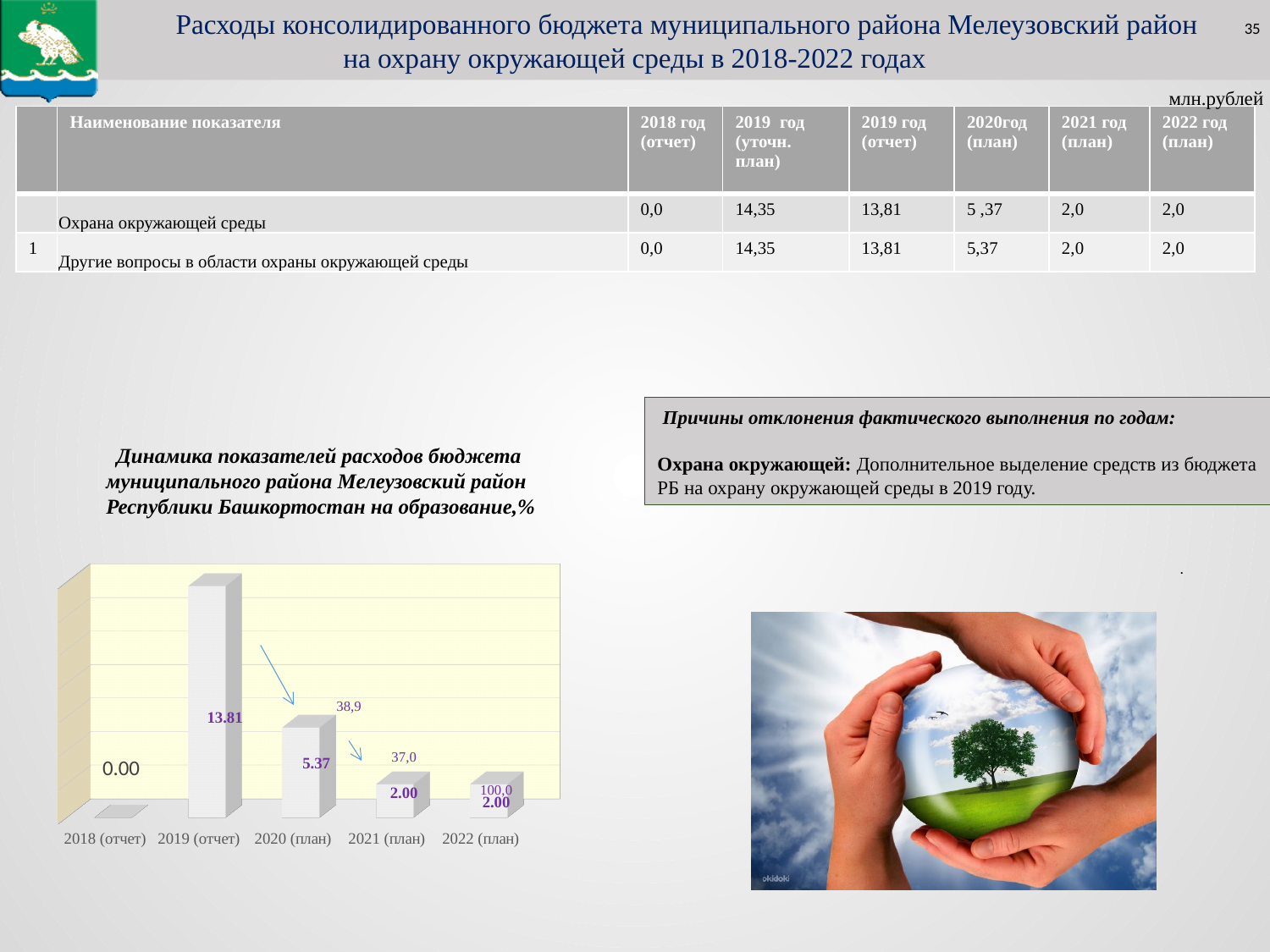
Which category has the lowest value in the bar chart? 2018 (отчет) What is the difference between the values for 2020 (план) and 2022 (план) in the bar chart? 3.37 Which is larger in the bar chart, the value for 2020 (план) or the value for 2021 (план)? 2020 (план) Do the values in the bar chart rise or fall from 2019 (отчет) to 2022 (план)? fall What type of chart is shown on the slide? bar chart What is the value for 2019 (отчет) in the bar chart? 13.81 What is the difference between the values for 2019 (отчет) and 2020 (план) in the bar chart? 8.44 What is the value for 2020 (план) in the bar chart? 5.37 How many categories (years) are shown on the x axis of the bar chart? 5 Which category has the highest value in the bar chart? 2019 (отчет) What is the value for 2021 (план) in the bar chart? 2.00 What is the value for 2018 (отчет) in the bar chart? 0.00